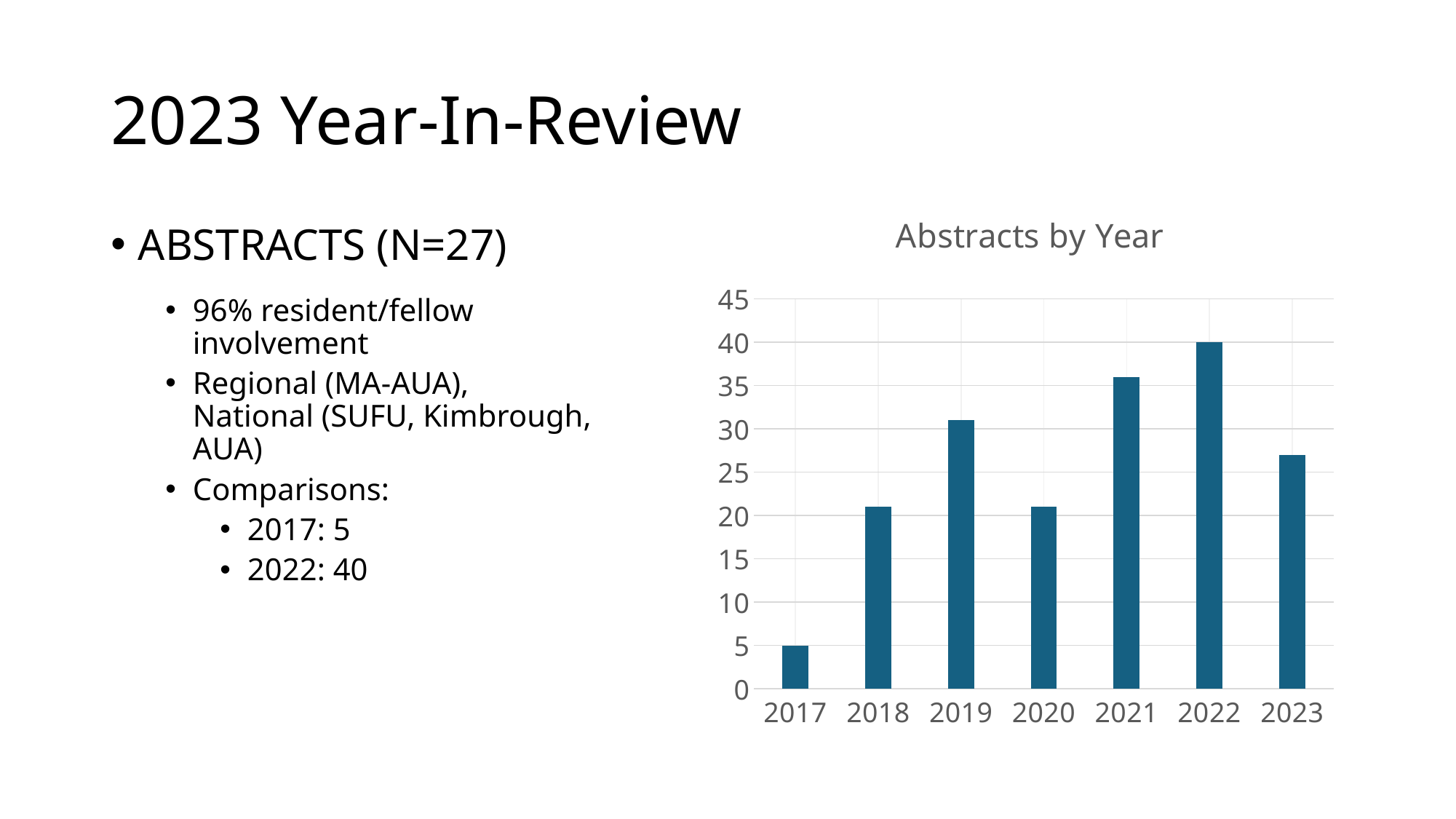
Which year has the lowest number of abstracts? 2017 How many abstracts were there in 2017? 5 What is the title of the chart? Abstracts by Year How many years are shown on the x axis of the chart? 7 Is the value for 2021 greater or less than 30? greater Does the number of abstracts rise or fall from 2022 to 2023? fall What kind of chart is shown on the slide? bar chart What is the difference in abstracts between 2022 and 2017? 35 Is the value for 2018 greater or less than 25? less How many abstracts were there in 2022? 40 Which year had more abstracts, 2021 or 2019? 2021 Which year has the highest number of abstracts? 2022